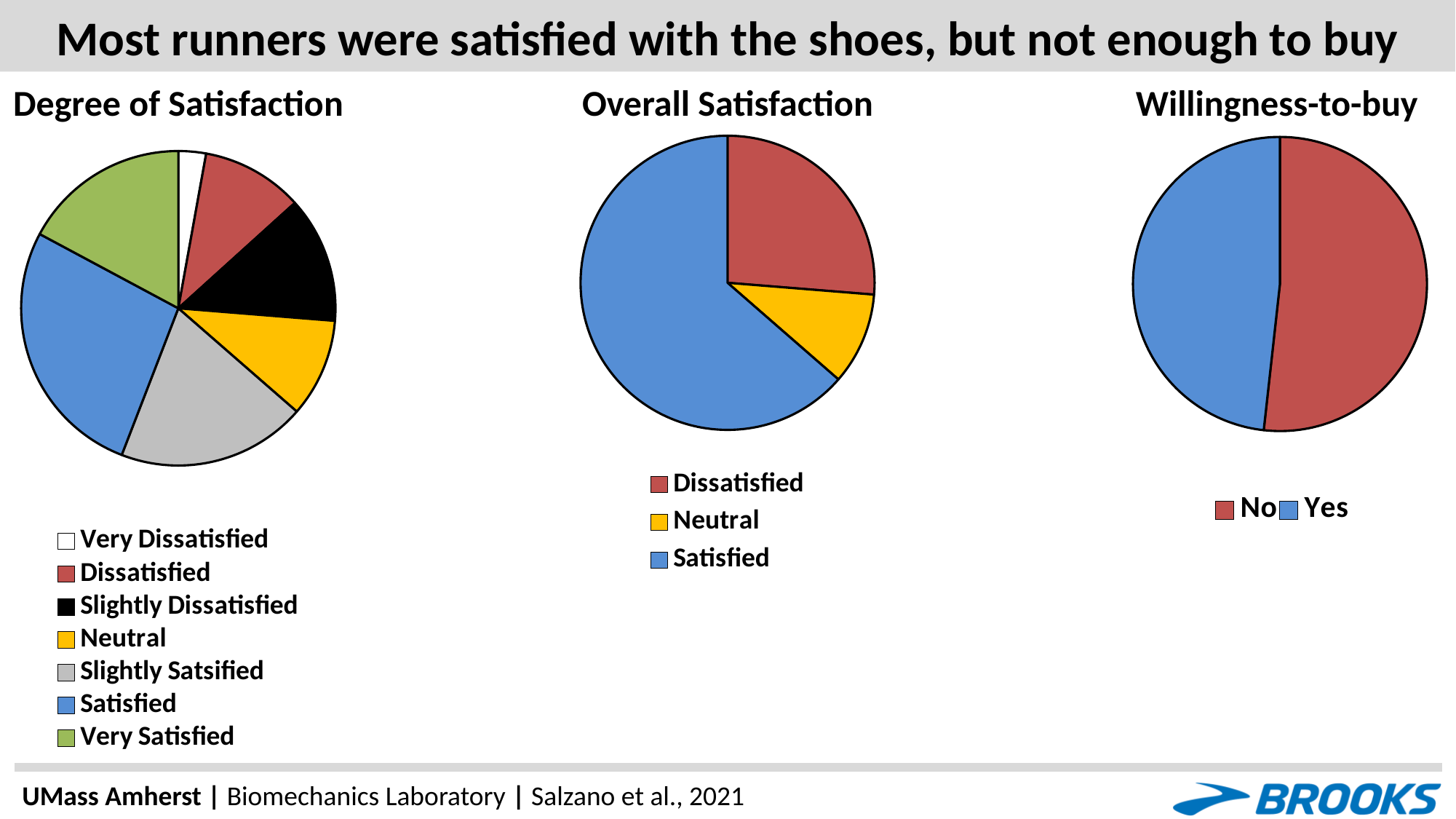
In the Overall Satisfaction chart, which category has the smallest slice? Neutral How many categories does the legend of the Overall Satisfaction chart list? 3 In the Overall Satisfaction chart, which slice is larger, Dissatisfied or Neutral? Dissatisfied In the Willingness-to-buy chart, what colour represents the Yes category? blue In the Degree of Satisfaction chart, which category has the smallest slice? Very Dissatisfied In the Degree of Satisfaction chart, which slice is larger, Very Satisfied or Very Dissatisfied? Very Satisfied How many categories does the legend of the Willingness-to-buy chart list? 2 In the Degree of Satisfaction chart, which slice is larger, Slightly Satisfied or Neutral? Slightly Satisfied How many categories does the legend of the Degree of Satisfaction chart list? 7 In the Degree of Satisfaction chart, which category has the largest slice? Satisfied In the Overall Satisfaction chart, which category has the largest slice? Satisfied What kind of chart is the Degree of Satisfaction chart? pie chart